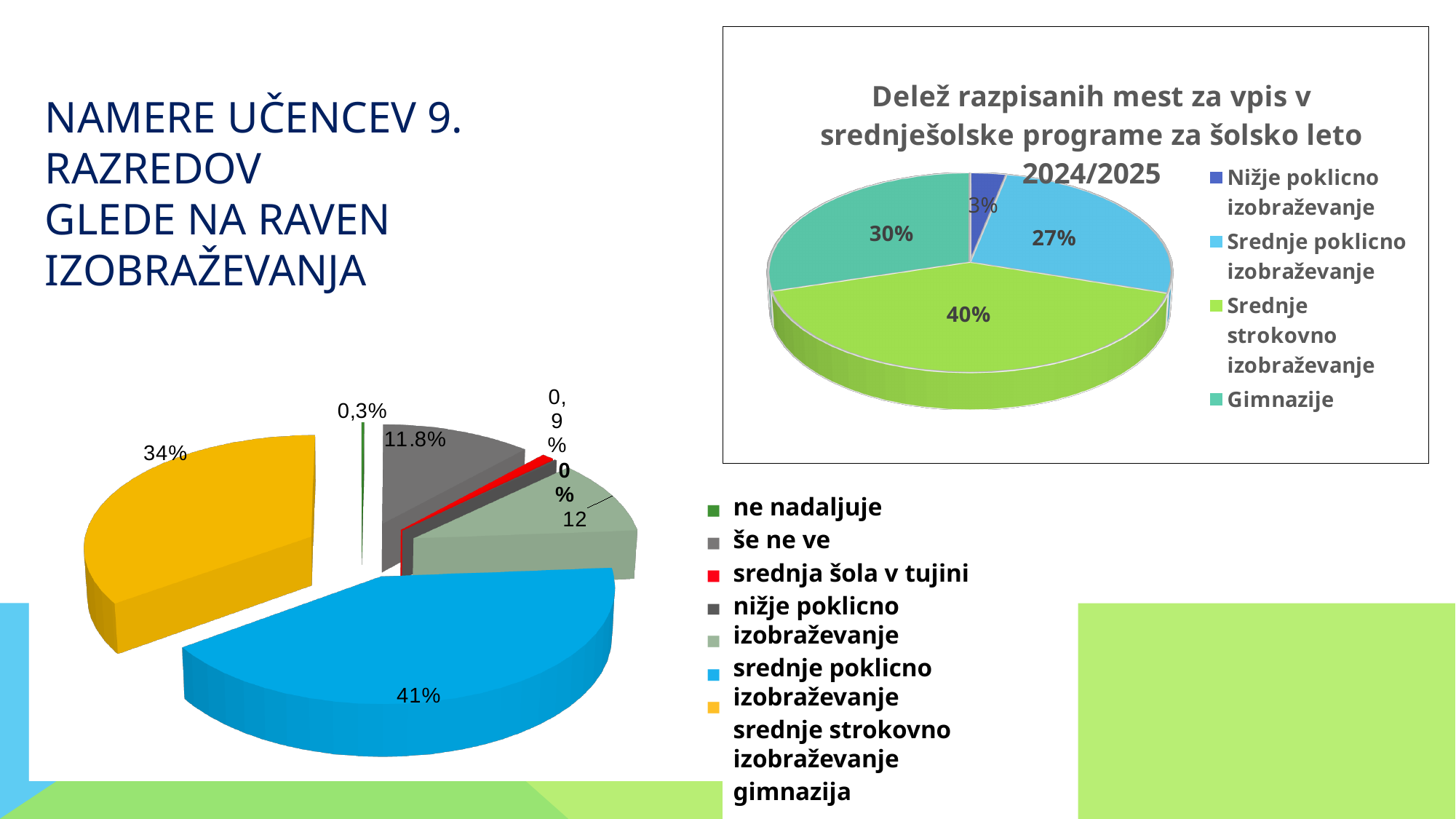
In the chart titled 'Delež razpisanih mest za vpis v srednješolske programe za šolsko leto 2024/2025', what is the difference between Srednje poklicno izobraževanje and Nižje poklicno izobraževanje? 24% In the pie chart in the lower left of the slide, what is the value for srednje strokovno izobraževanje? 41% In the pie chart in the lower left of the slide, what is the value for gimnazija? 34% In the chart titled 'Delež razpisanih mest za vpis v srednješolske programe za šolsko leto 2024/2025', which category has the smallest slice? Nižje poklicno izobraževanje How many categories does the legend of the chart titled 'Delež razpisanih mest za vpis v srednješolske programe za šolsko leto 2024/2025' list? 4 How many categories does the legend of the pie chart in the lower left of the slide list? 7 In the chart titled 'Delež razpisanih mest za vpis v srednješolske programe za šolsko leto 2024/2025', what share is Gimnazije? 30% In the pie chart in the lower left of the slide, which category has the largest slice? srednje strokovno izobraževanje What kind of chart is the one in the lower left of the slide? Pie chart In the chart titled 'Delež razpisanih mest za vpis v srednješolske programe za šolsko leto 2024/2025', which category has the largest slice? Srednje strokovno izobraževanje In the chart titled 'Delež razpisanih mest za vpis v srednješolske programe za šolsko leto 2024/2025', what share is Nižje poklicno izobraževanje? 3% In the chart titled 'Delež razpisanih mest za vpis v srednješolske programe za šolsko leto 2024/2025', what share is Srednje strokovno izobraževanje? 40%